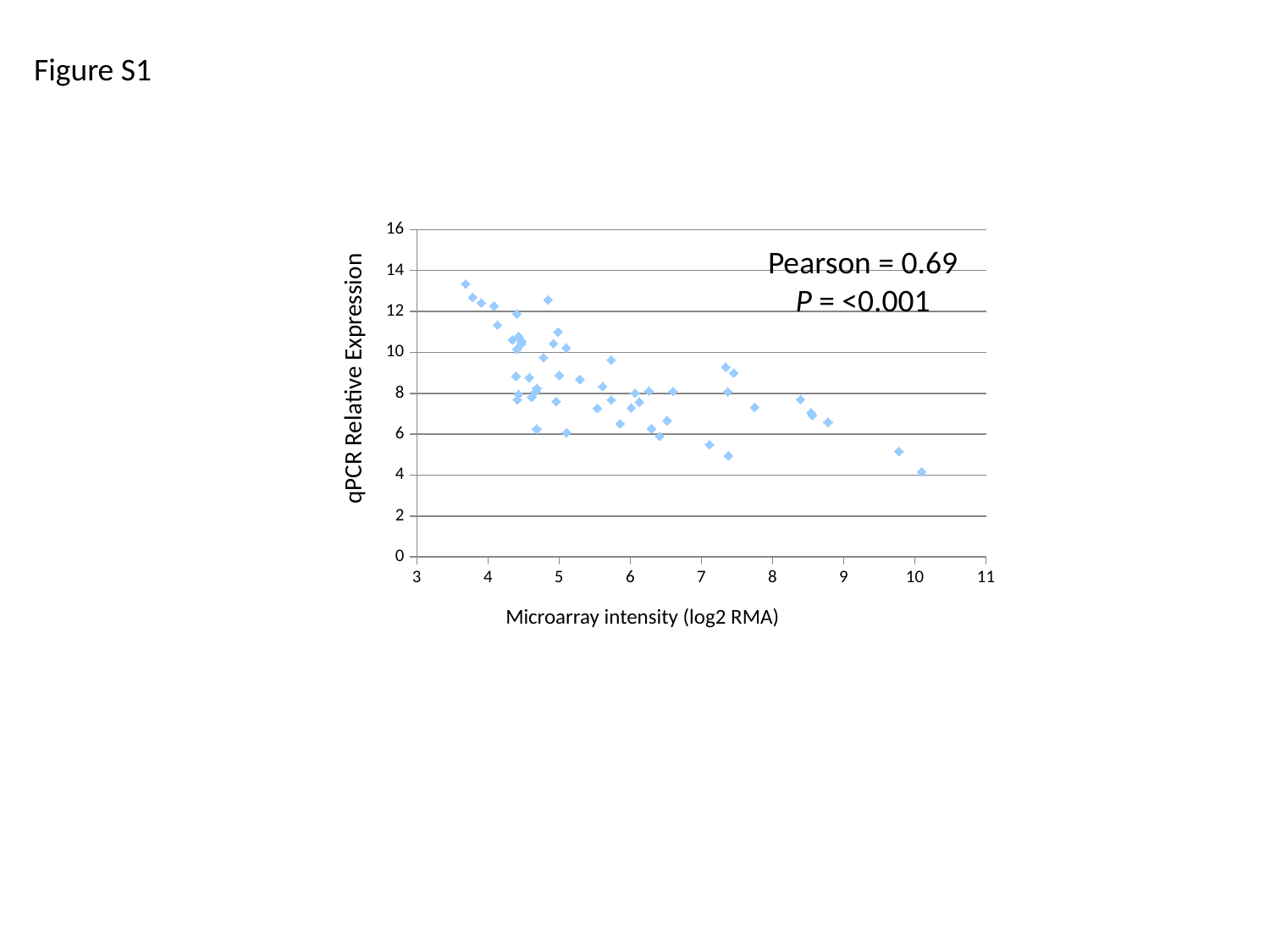
Is the highest qPCR Relative Expression value plotted greater or less than 14? less What is the title of the x axis? Microarray intensity (log2 RMA) Which has the higher qPCR Relative Expression: the leftmost point or the rightmost point? the leftmost point Is the qPCR Relative Expression of the leftmost point (near 3.7 on the x axis) greater or less than 12? greater Do the qPCR Relative Expression values generally rise or fall as Microarray intensity increases along the x axis? fall What Pearson correlation value is printed on the chart? 0.69 What is the maximum value shown on the y axis? 16 What is the title of the y axis? qPCR Relative Expression What P value is printed on the chart? <0.001 What kind of chart is shown on the slide? scatter plot Is the qPCR Relative Expression of the rightmost point (at about 10 on the x axis) greater or less than 6? less